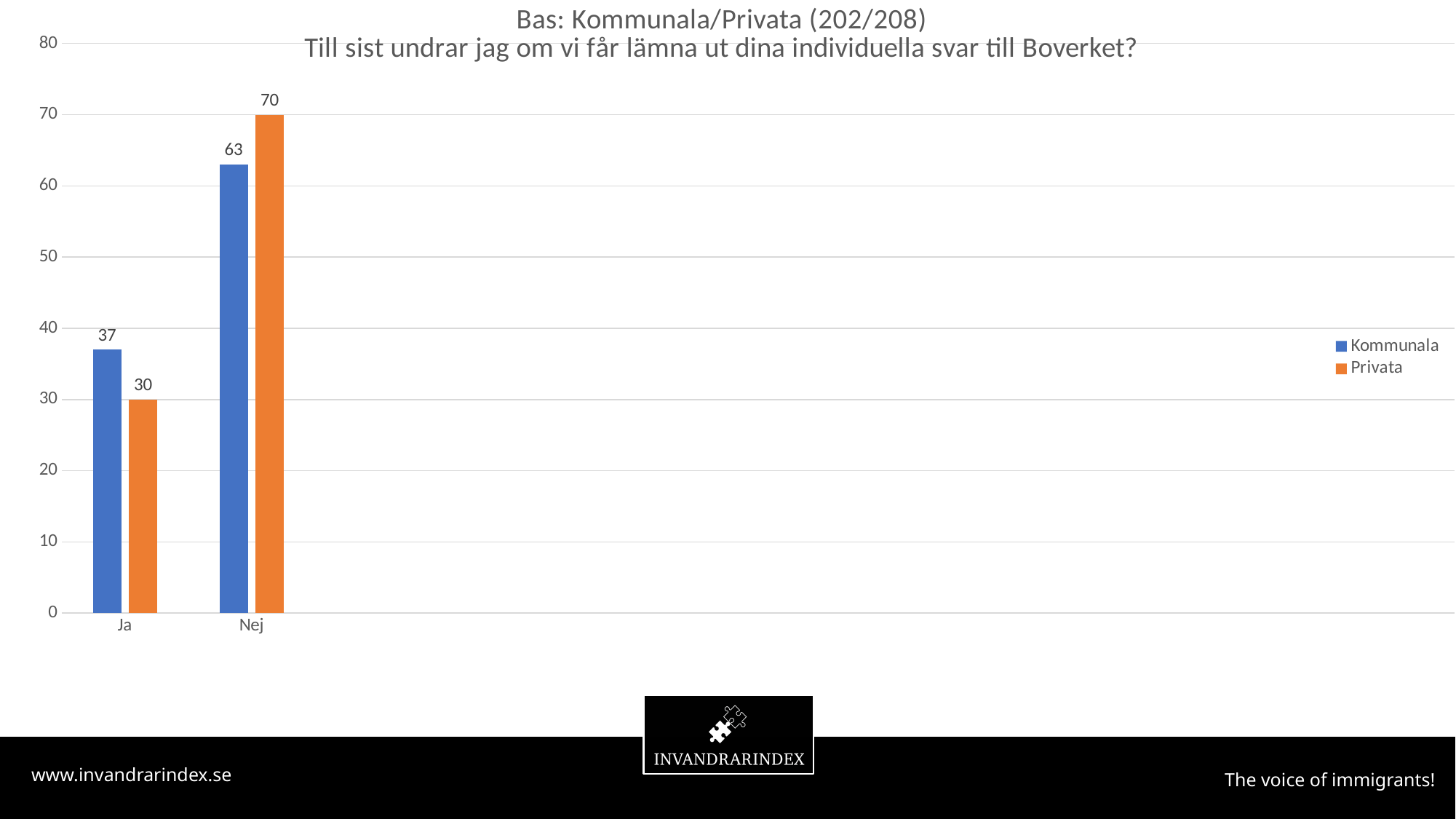
In the Ja category, which series has the larger value, Kommunala or Privata? Kommunala Which category has the highest value for the Privata series? Nej What is the value for Privata in the Nej category? 70 What is the value for Privata in the Ja category? 30 Is the value for Kommunala in the Nej category greater or less than 60? greater Which category has the lowest value for the Kommunala series? Ja What is the difference between the Privata and Kommunala values in the Nej category? 7 How many categories are shown on the x axis? 2 What is the value for Kommunala in the Nej category? 63 What is the value for Kommunala in the Ja category? 37 What kind of chart is shown on the slide? bar chart How many series does the legend list? 2